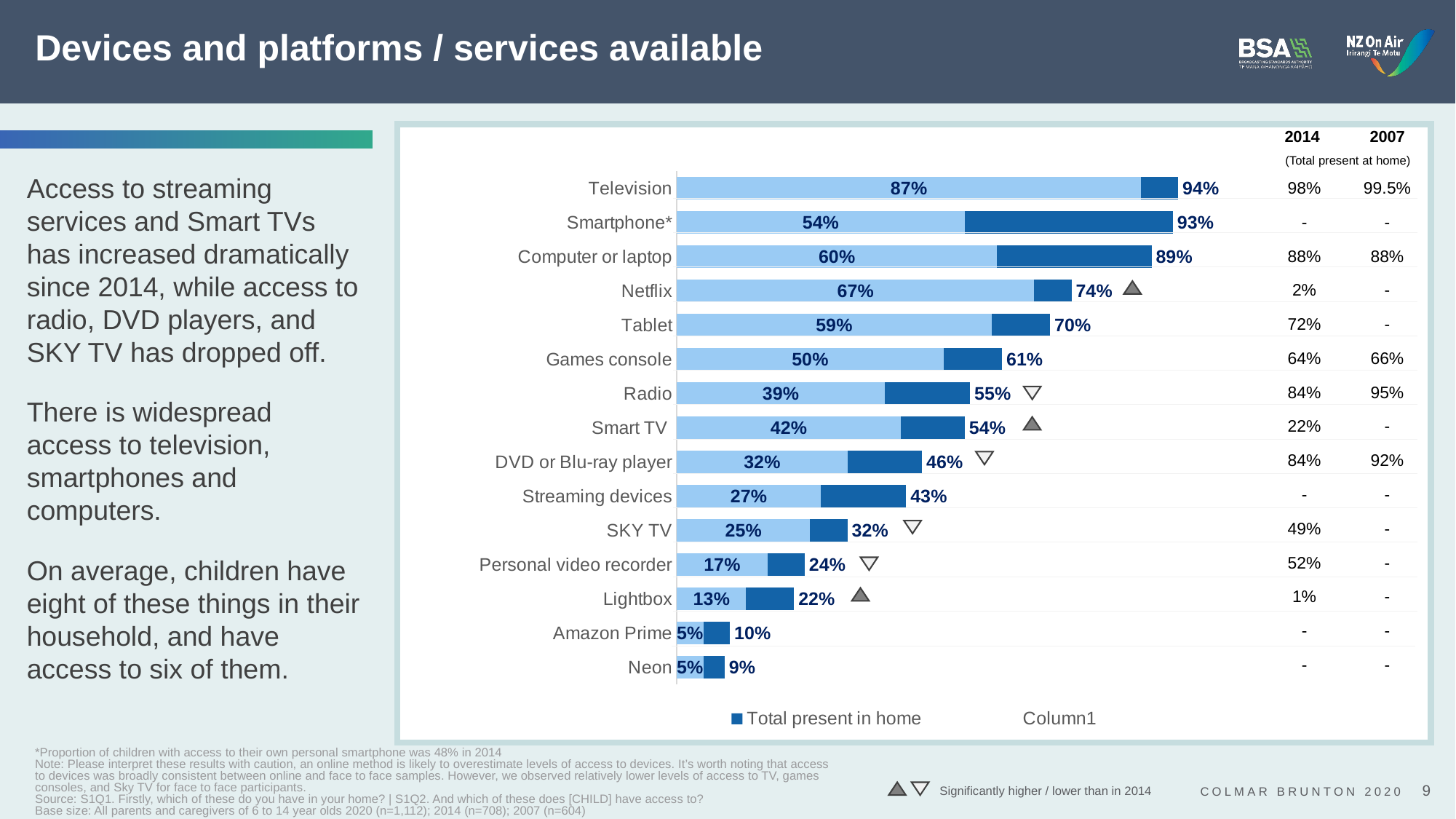
What value is printed inside the light blue bar for Smartphone*? 54% What type of chart is shown on the slide? Bar chart What is the 'Total present in home' value for Television? 94% What is the difference between the 'Total present in home' value for Television (94%) and the value printed inside its light blue bar (87%)? 7 percentage points How many categories are plotted in the bar chart? 15 Which category has the highest 'Total present in home' value? Television Which has a higher 'Total present in home' value, Tablet or Games console? Tablet Which category has the lowest 'Total present in home' value? Neon What is the 'Total present in home' value for Netflix? 74% How many entries does the chart legend list? 2 In the 2014 column to the right of the chart, what value is shown for Netflix? 2% What is the 'Total present in home' value for Streaming devices? 43%